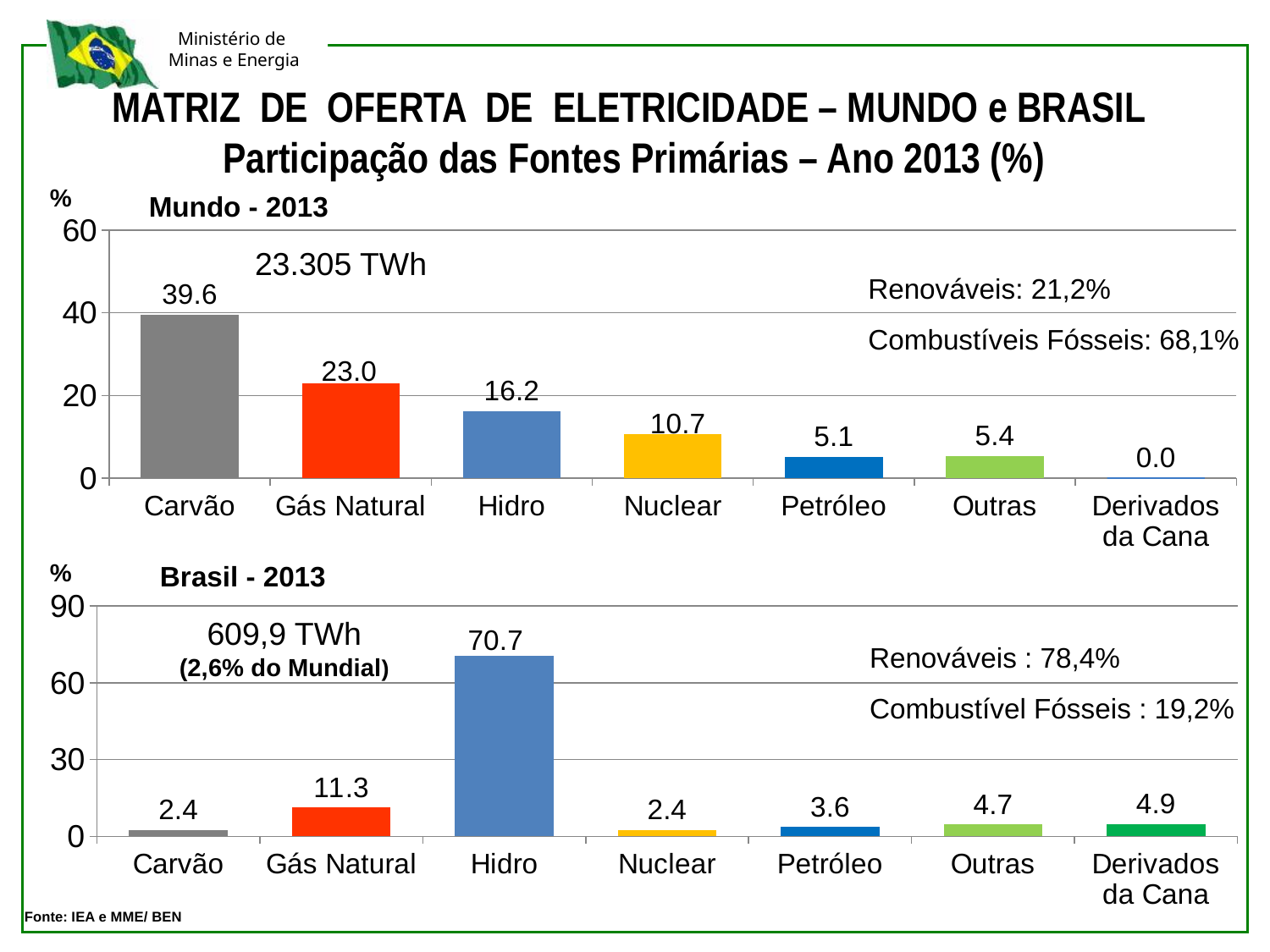
In the 'Mundo - 2013' chart, what is the value for Carvão? 39.6 In the 'Mundo - 2013' chart, what is the difference between the values for Carvão and Gás Natural? 16.6 What kind of chart is the 'Mundo - 2013' chart? Bar chart In the 'Mundo - 2013' chart, which category has the lowest value? Derivados da Cana In the 'Brasil - 2013' chart, what is the value for Petróleo? 3.6 In the 'Mundo - 2013' chart, which category has the highest value? Carvão In the 'Brasil - 2013' chart, which is larger, the value for Derivados da Cana or the value for Petróleo? Derivados da Cana In the 'Mundo - 2013' chart, which is larger, the value for Hidro or the value for Nuclear? Hidro In the 'Brasil - 2013' chart, what is the value for Hidro? 70.7 In the 'Brasil - 2013' chart, what is the difference between the values for Hidro and Gás Natural? 59.4 How many categories are shown in the 'Brasil - 2013' chart? 7 In the 'Brasil - 2013' chart, which category has the highest value? Hidro